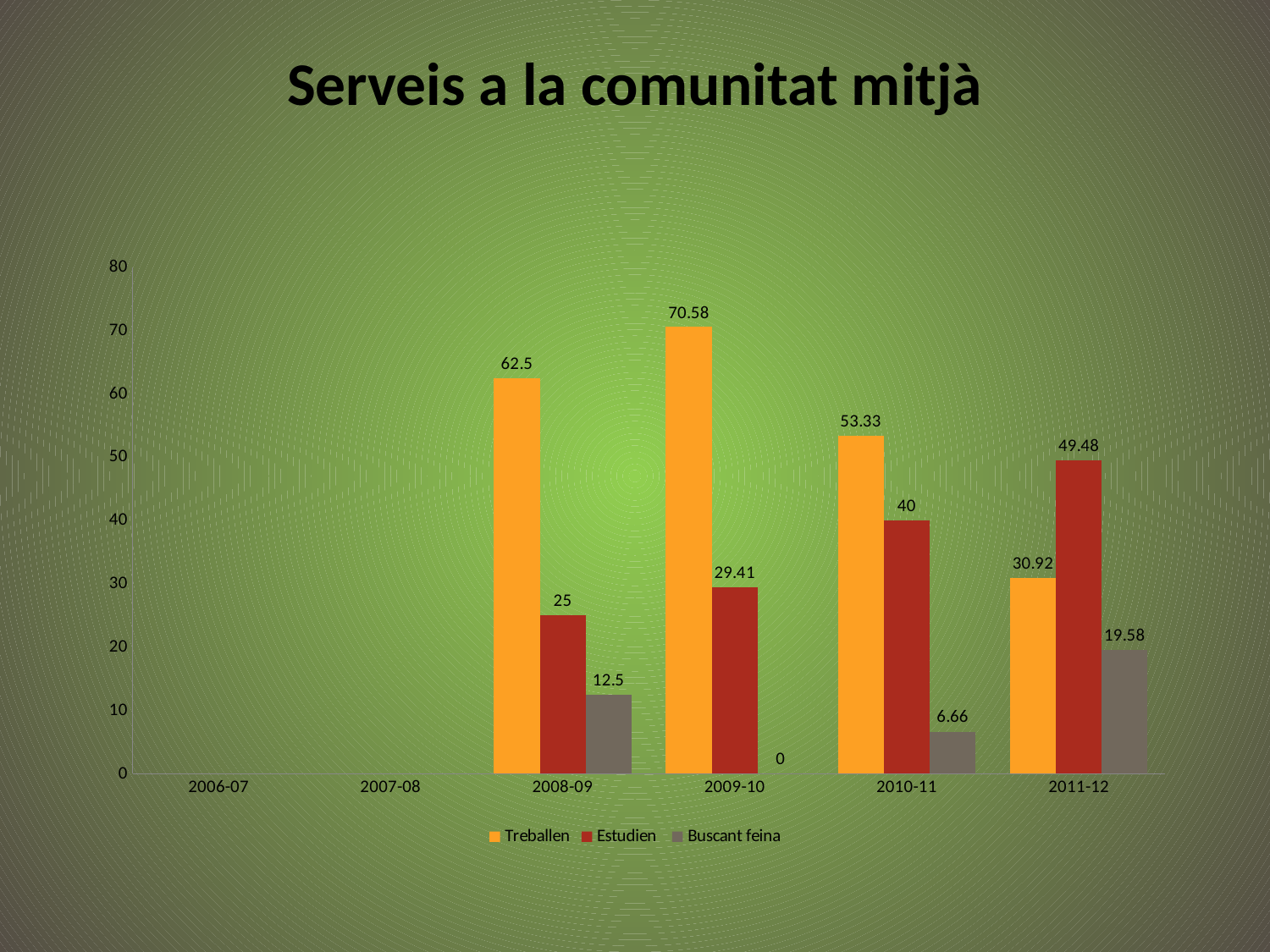
What is the difference between the Treballen value in 2008-09 and the Treballen value in 2011-12? 31.58 What kind of chart is shown on the slide? Bar chart What is the value for Estudien in 2008-09? 25 In which year is the Treballen value highest? 2009-10 What is the value for Buscant feina in 2010-11? 6.66 What is the value for Estudien in 2011-12? 49.48 How many series does the legend list? 3 What is the title of the chart? Serveis a la comunitat mitjà Which is larger in 2011-12: Treballen or Estudien? Estudien How many year categories are shown on the x axis? 6 Among the years with data labels, in which year is the Buscant feina value lowest? 2009-10 What is the value for Treballen in 2009-10? 70.58